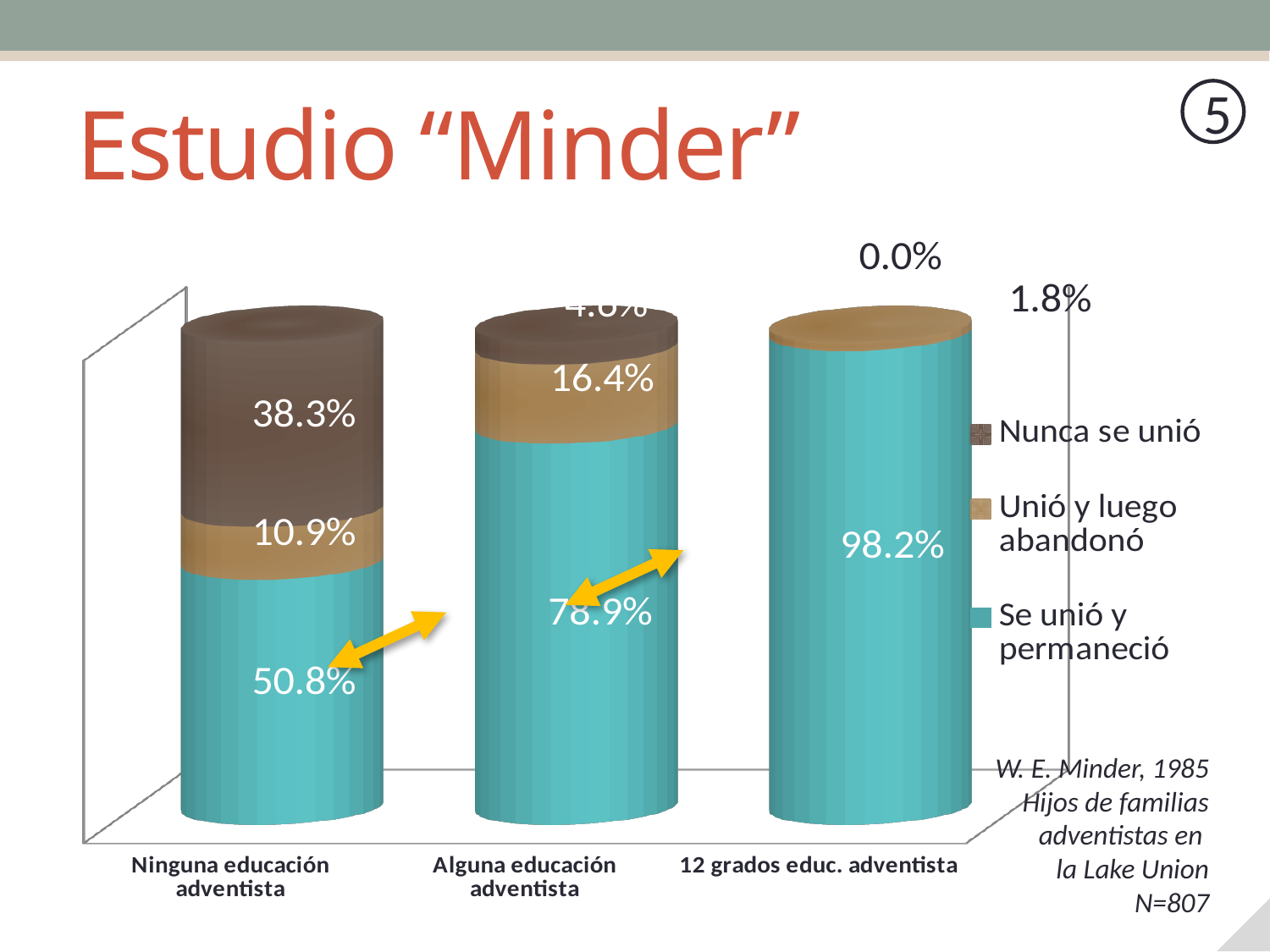
What is the difference between the 'Se unió y permaneció' values for '12 grados educ. adventista' and 'Ninguna educación adventista'? 47.4% What is the 'Unió y luego abandonó' value for 'Alguna educación adventista'? 16.4% What percentage of those with no Adventist education (Ninguna educación adventista) joined and remained (Se unió y permaneció)? 50.8% What is the value of 'Nunca se unió' for the 'Ninguna educación adventista' category? 38.3% Which is larger: the 'Unió y luego abandonó' value for 'Ninguna educación adventista' or for 'Alguna educación adventista'? Alguna educación adventista What is the 'Se unió y permaneció' value for '12 grados educ. adventista'? 98.2% How many categories are shown on the x axis of the chart? 3 Does the 'Se unió y permaneció' value rise or fall from left to right across the categories? Rise Which category has the lowest 'Nunca se unió' value? 12 grados educ. adventista How many series does the chart legend list? 3 What is the 'Nunca se unió' value for '12 grados educ. adventista'? 0.0% Which category has the highest 'Se unió y permaneció' value? 12 grados educ. adventista